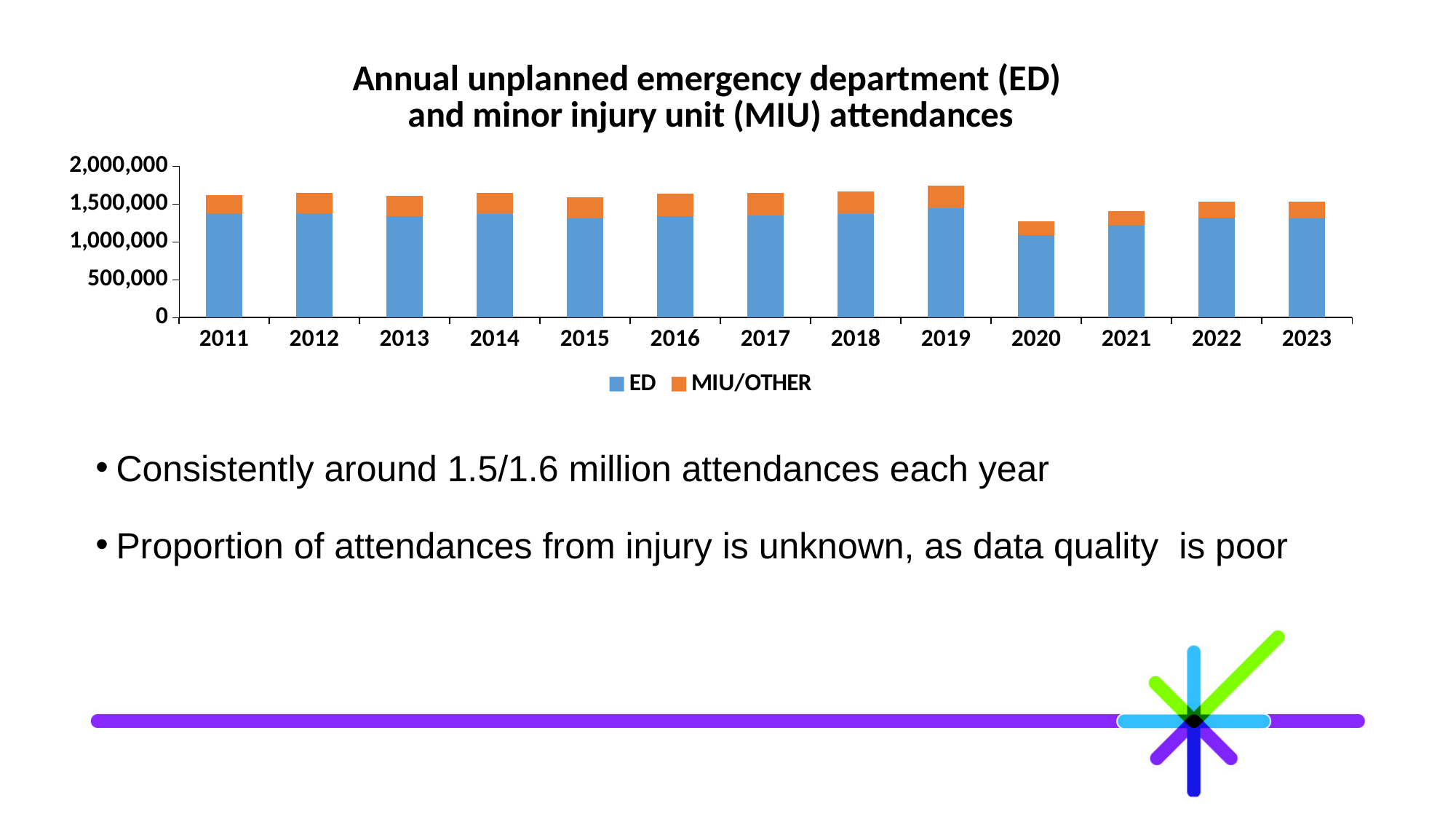
What are the two series named in the chart's legend? ED and MIU/OTHER Is the total attendances value for 2019 greater or less than 1,500,000? greater Which year has the lowest ED attendances? 2020 Which year has the lowest total attendances in the chart? 2020 How many years are shown on the x axis of the chart? 13 Which year has larger total attendances, 2019 or 2021? 2019 Is the ED attendances value for 2020 greater or less than 1,000,000? greater Which year has the highest total attendances in the chart? 2019 How many series does the chart's legend list? 2 What is the title of the chart? Annual unplanned emergency department (ED) and minor injury unit (MIU) attendances Is the total attendances value for 2020 greater or less than 1,500,000? less What kind of chart is shown on the slide? Stacked bar chart